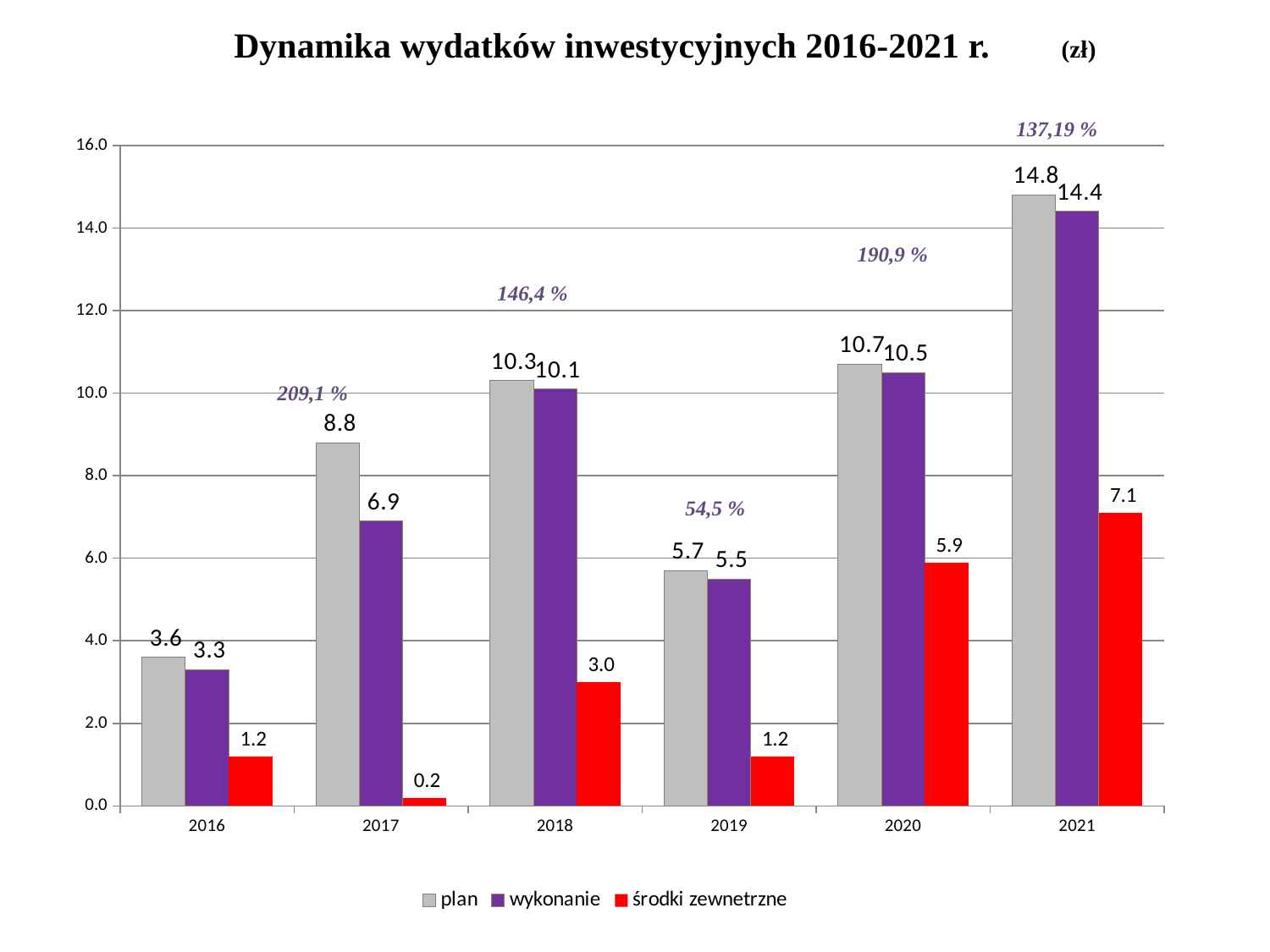
Which year has the highest 'wykonanie' value? 2021 What is the difference between 'plan' and 'wykonanie' in 2017? 1.9 What percentage label is shown above the 2021 bars? 137,19 % Which is larger in 2019: 'plan' or 'wykonanie'? plan What is the value of 'środki zewnetrzne' for 2020? 5.9 What is the value of 'wykonanie' for 2017? 6.9 What kind of chart is shown on the slide? bar chart Is the 'środki zewnetrzne' value for 2021 greater or less than 6.0? greater What is the value of 'plan' for 2018? 10.3 Which year has the lowest 'środki zewnetrzne' value? 2017 How many years are shown on the x axis? 6 How many series does the legend list? 3